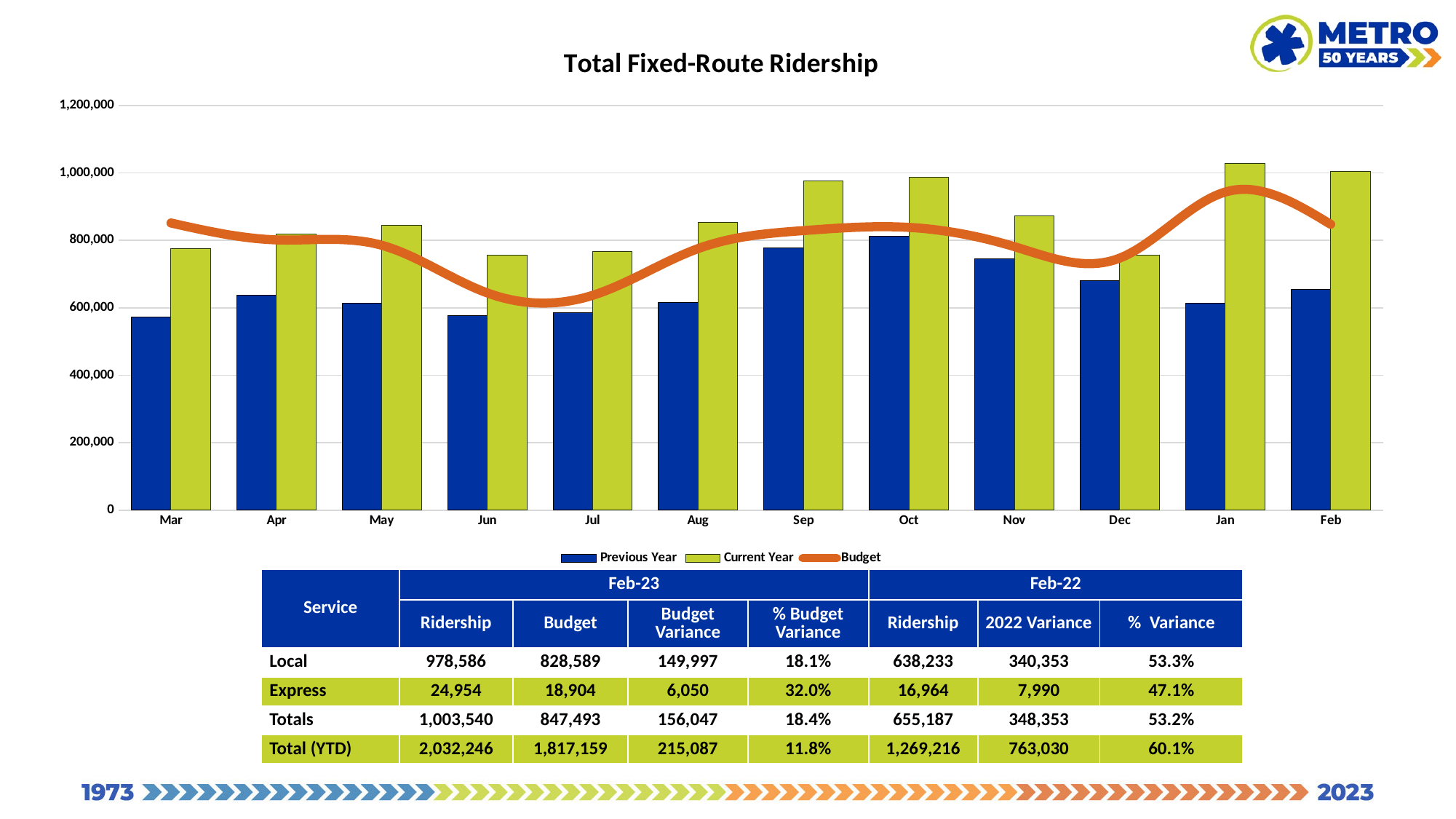
In Feb, which is larger: the Previous Year bar or the Current Year bar? Current Year Which series is drawn as an orange line in the chart? Budget Which month has the highest Previous Year ridership in the chart? Oct Is the Current Year value for Sep greater or less than 1,000,000? less Which month has the highest Current Year ridership in the chart? Jan How many series does the chart legend list? 3 What kind of chart is used to show the Previous Year and Current Year series? Bar chart Does the Previous Year series rise or fall from Oct to Jan? Fall Is the Previous Year value for Mar greater or less than 600,000? less Is the Current Year value for Jan greater or less than 1,000,000? greater How many months are shown on the x axis of the chart? 12 What is the title of the chart? Total Fixed-Route Ridership